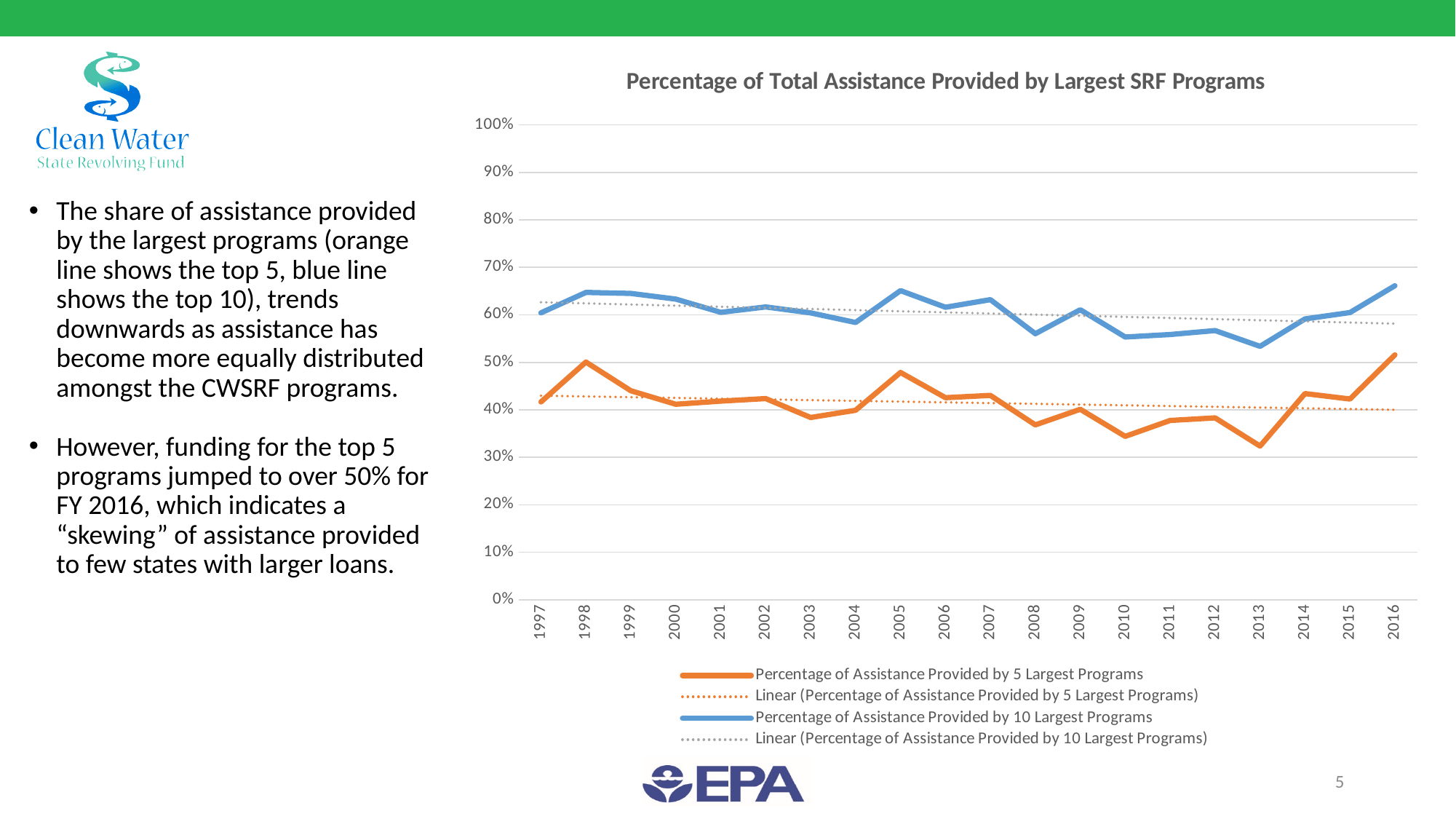
How many years are shown on the x axis of the chart? 20 In which year is the Percentage of Assistance Provided by 5 Largest Programs lowest? 2013 Is the value for the 5 Largest Programs in 2013 greater or less than 40%? less What kind of chart is shown on the slide? line chart Does the dotted linear trend line for the 5 Largest Programs rise or fall from 1997 to 2016? fall For the 5 Largest Programs, which year has the larger value, 2005 or 2010? 2005 What is the title of the chart? Percentage of Total Assistance Provided by Largest SRF Programs In which year is the Percentage of Assistance Provided by 10 Largest Programs lowest? 2013 Is the value for the 10 Largest Programs in 2013 greater or less than 60%? less Is the value for the 5 Largest Programs in 2016 greater or less than 50%? greater How many entries does the chart legend list? 4